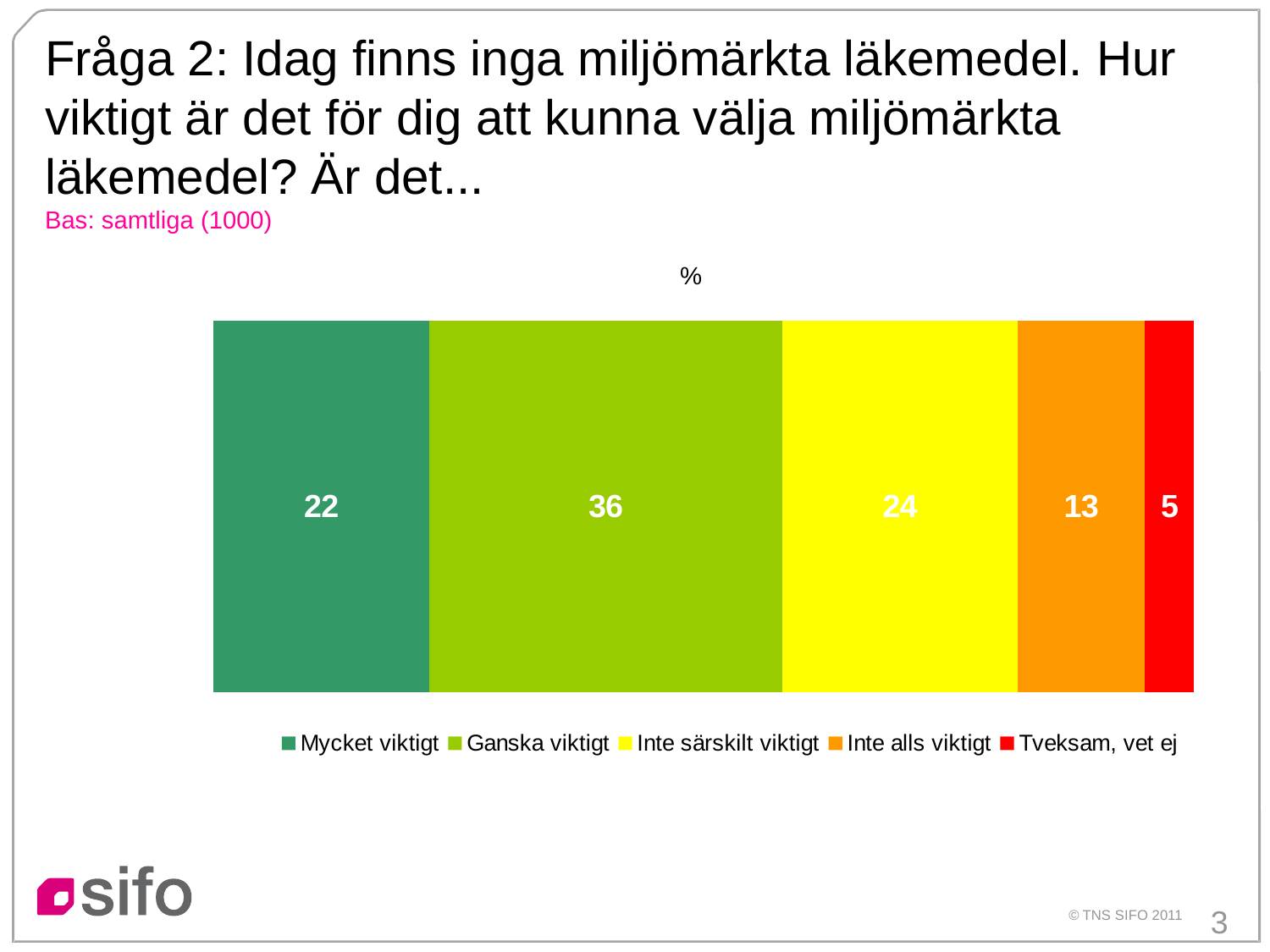
Which response category has the highest value? Ganska viktigt What colour is the segment for "Inte alls viktigt"? Orange What kind of chart is shown on the slide? Stacked bar chart What is the difference between the values for "Ganska viktigt" and "Inte alls viktigt"? 23 What value is shown for "Ganska viktigt"? 36 How many series does the legend list? 5 What value is shown for "Tveksam, vet ej"? 5 What is the total of the stacked bar? 100 Which response category has the lowest value? Tveksam, vet ej What value is shown for "Mycket viktigt"? 22 What value is shown for "Inte särskilt viktigt"? 24 Which is larger, the value for "Mycket viktigt" or the value for "Inte särskilt viktigt"? Inte särskilt viktigt